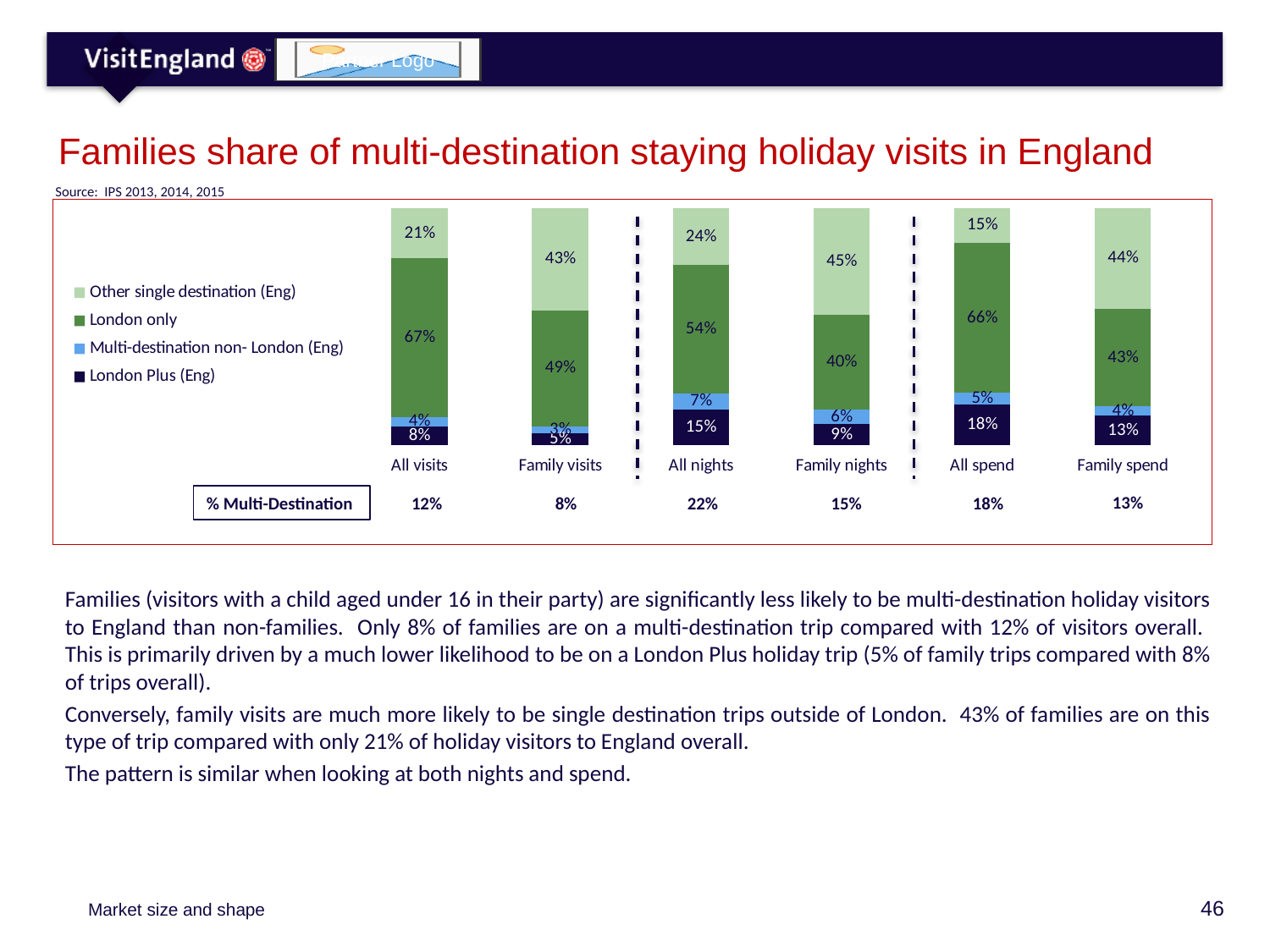
What is the London only value for All visits? 67% What is the Other single destination (Eng) value for Family visits? 43% What is the London Plus (Eng) value for All nights? 15% What kind of chart is shown on the slide? Stacked bar chart What is the Multi-destination non- London (Eng) value for Family nights? 6% How many categories are shown on the x axis? 6 What is the difference between the Other single destination (Eng) values for Family visits and All visits? 22% What is the London Plus (Eng) value for All spend? 18% Is the London only value larger for All nights or Family nights? All nights Which category has the highest London only value? All visits Which category has the lowest London Plus (Eng) value? Family visits How many series does the legend list? 4